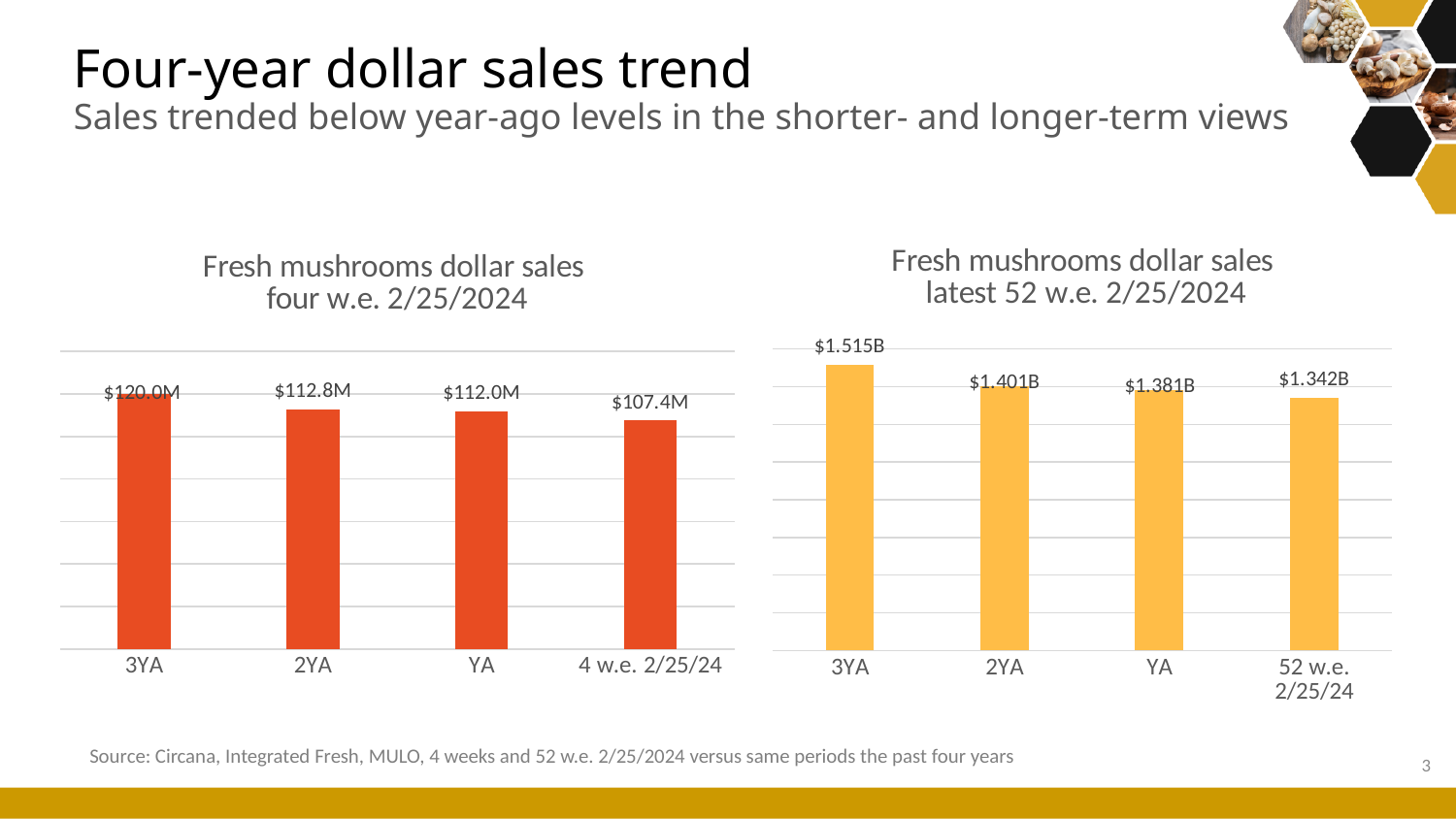
In the 'Fresh mushrooms dollar sales latest 52 w.e. 2/25/2024' chart, what is the difference between the 3YA value and the 2YA value? $0.114B In the 'Fresh mushrooms dollar sales latest 52 w.e. 2/25/2024' chart, do the values rise or fall from 3YA to 52 w.e. 2/25/24? Fall In the 'Fresh mushrooms dollar sales latest 52 w.e. 2/25/2024' chart, what is the value for 52 w.e. 2/25/24? $1.342B In the 'Fresh mushrooms dollar sales four w.e. 2/25/2024' chart, what is the value for 3YA? $120.0M In the 'Fresh mushrooms dollar sales latest 52 w.e. 2/25/2024' chart, which period has the lowest value? 52 w.e. 2/25/24 What kind of chart is the 'Fresh mushrooms dollar sales four w.e. 2/25/2024' chart? Bar chart In the 'Fresh mushrooms dollar sales four w.e. 2/25/2024' chart, what is the difference between the 3YA value and the 4 w.e. 2/25/24 value? $12.6M How many periods are shown on the x axis of the 'Fresh mushrooms dollar sales latest 52 w.e. 2/25/2024' chart? 4 In the 'Fresh mushrooms dollar sales latest 52 w.e. 2/25/2024' chart, what is the value for YA? $1.381B In the 'Fresh mushrooms dollar sales four w.e. 2/25/2024' chart, which period has the highest value? 3YA In the 'Fresh mushrooms dollar sales four w.e. 2/25/2024' chart, what is the value for 4 w.e. 2/25/24? $107.4M In the 'Fresh mushrooms dollar sales four w.e. 2/25/2024' chart, which is larger, the value for 2YA or the value for YA? 2YA